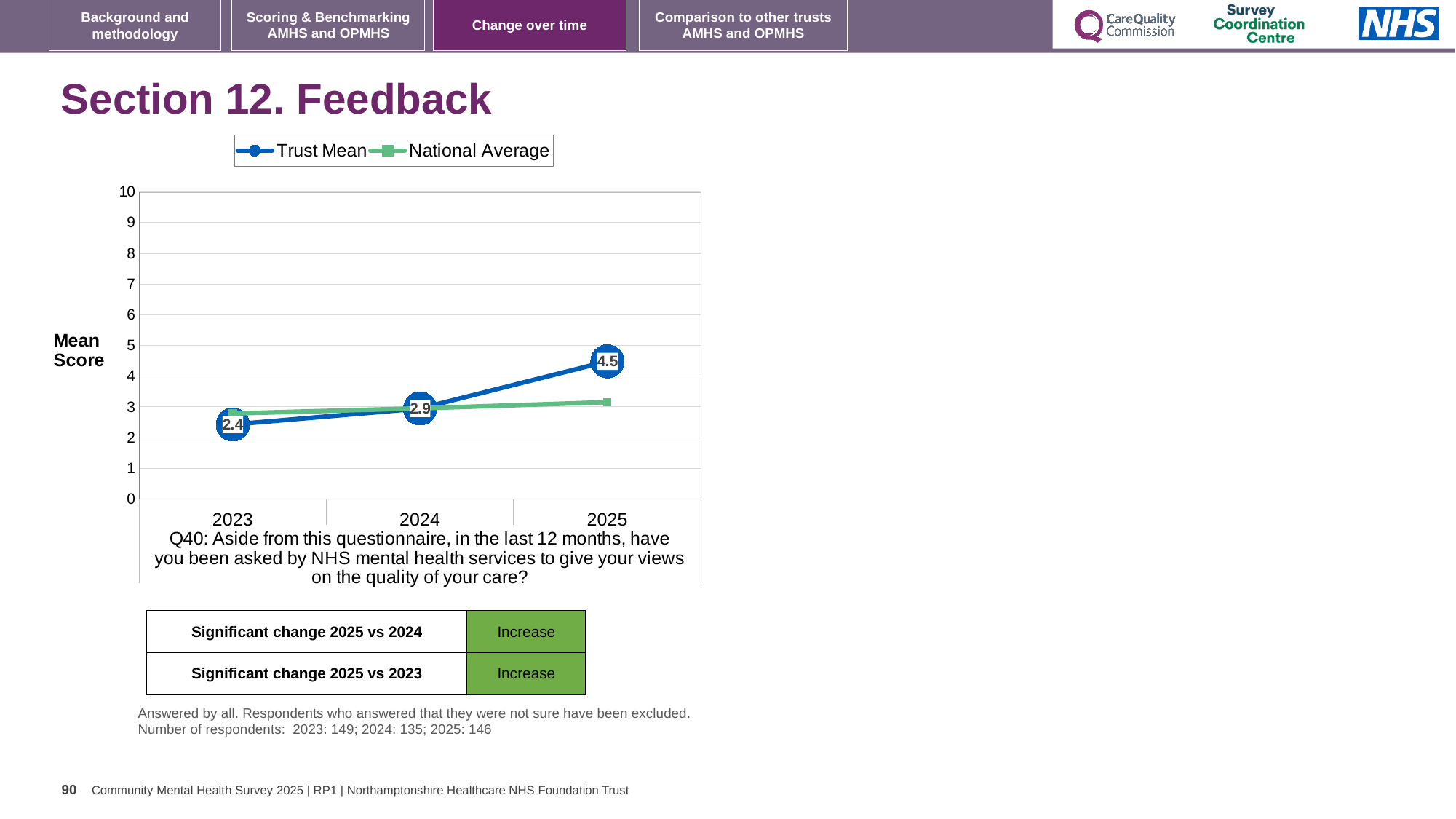
What is the difference between the Trust Mean in 2025 and in 2023? 2.1 What is the difference between the Trust Mean in 2025 and in 2024? 1.6 What is the Trust Mean value for 2024? 2.9 How many series does the legend list? 2 What is the Trust Mean value for 2025? 4.5 In 2025, which is larger, the Trust Mean or the National Average? Trust Mean In which year is the Trust Mean lowest? 2023 Does the Trust Mean rise or fall from 2023 to 2025? rise Is the National Average value for 2023 greater or less than 3? less In which year is the Trust Mean highest? 2025 What is the Trust Mean value for 2023? 2.4 What kind of chart is shown on the slide? line chart